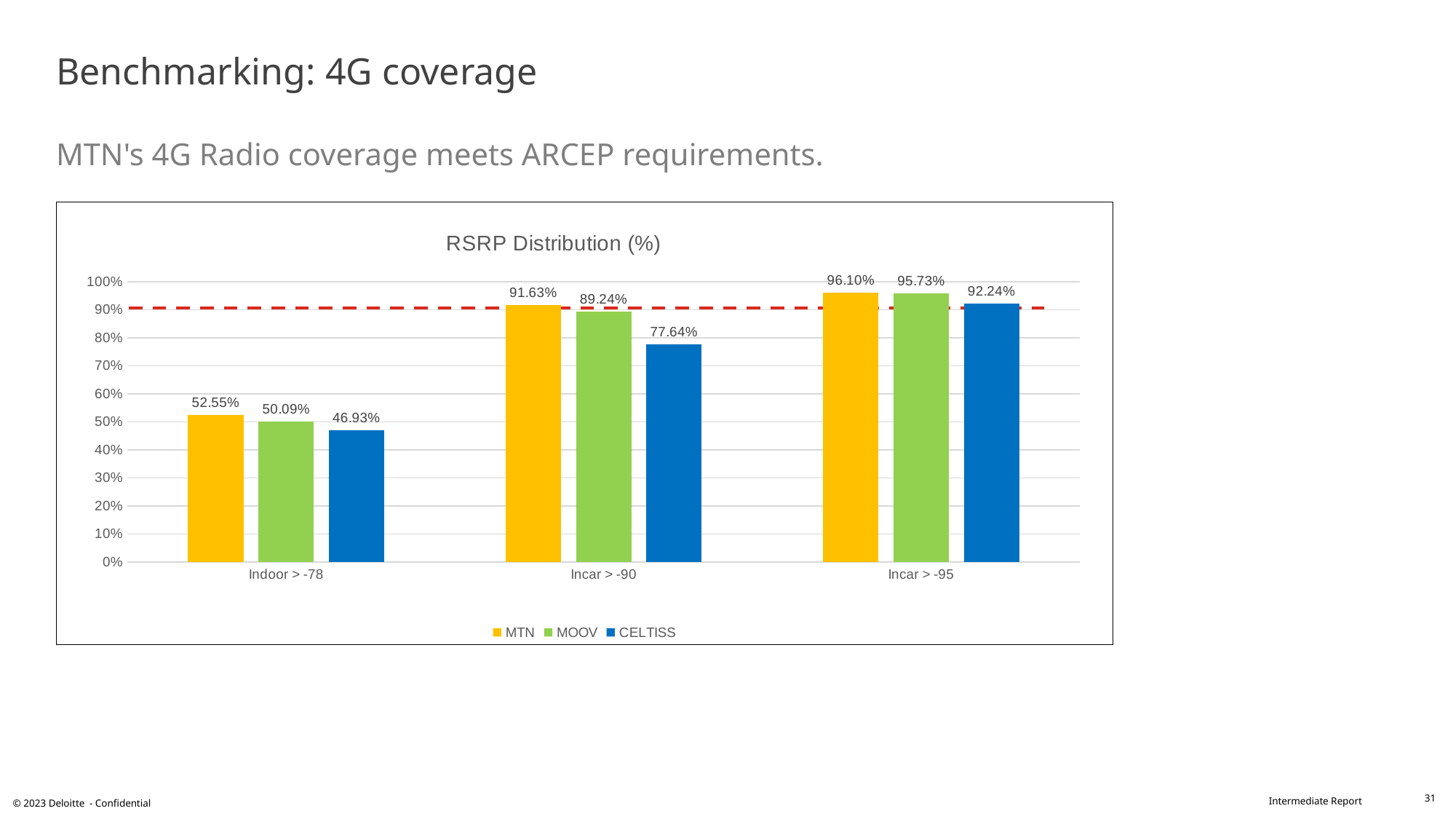
How many categories are shown on the x axis? 3 What is the value for MOOV in the Incar > -95 category? 95.73% How many series does the legend list? 3 Is the value for CELTISS in the Incar > -90 category greater or less than 80%? less What is the value for CELTISS in the Incar > -90 category? 77.64% What is the difference between MTN and CELTISS in the Incar > -90 category? 13.99% Which operator has the highest value in the Incar > -95 category? MTN What is the value for MTN in the Indoor > -78 category? 52.55% Which operator has the lowest value in the Indoor > -78 category? CELTISS What is the title of the chart? RSRP Distribution (%) Which is larger: MOOV in Incar > -90 or CELTISS in Incar > -95? CELTISS in Incar > -95 What kind of chart is shown on the slide? Bar chart